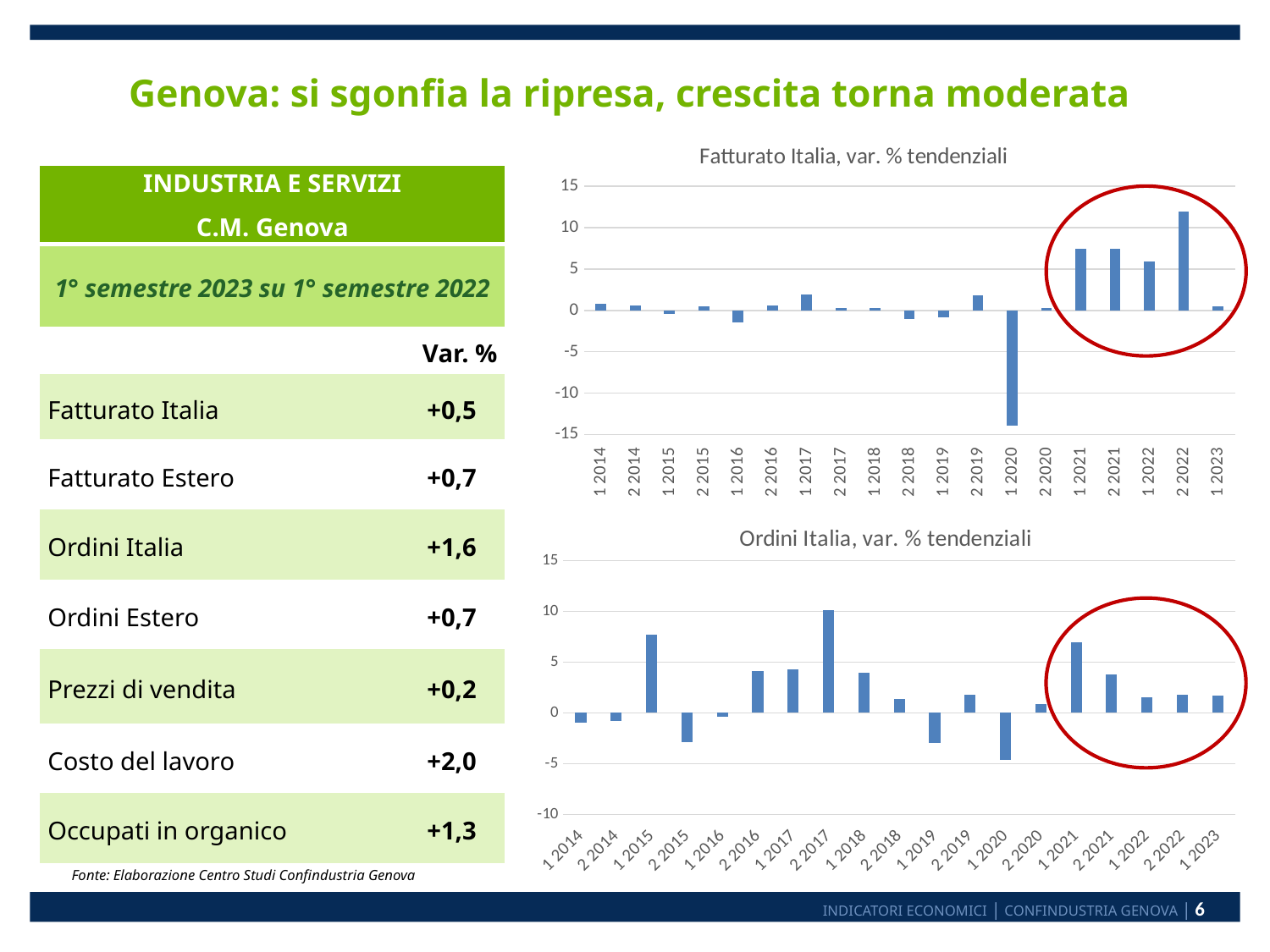
In the 'Fatturato Italia, var. % tendenziali' chart, does the value rise or fall from 2 2022 to 1 2023? fall In the 'Fatturato Italia, var. % tendenziali' chart, which period has the lowest value? 1 2020 In the 'Fatturato Italia, var. % tendenziali' chart, which period has the highest value? 2 2022 In the 'Ordini Italia, var. % tendenziali' chart, does the value rise or fall from 1 2021 to 1 2022? fall What kind of chart is the 'Fatturato Italia, var. % tendenziali' chart? bar chart How many periods are plotted on the x axis of the 'Ordini Italia, var. % tendenziali' chart? 19 In the 'Ordini Italia, var. % tendenziali' chart, which period has the lowest value? 1 2020 In the 'Fatturato Italia, var. % tendenziali' chart, is the value for 1 2020 greater or less than -10? less In the 'Ordini Italia, var. % tendenziali' chart, is the value for 1 2015 greater or less than 5? greater In the 'Fatturato Italia, var. % tendenziali' chart, is the value for 2 2022 greater or less than 10? greater In the 'Fatturato Italia, var. % tendenziali' chart, which is larger, the value for 2 2022 or the value for 1 2021? 2 2022 In the 'Ordini Italia, var. % tendenziali' chart, which period has the highest value? 2 2017